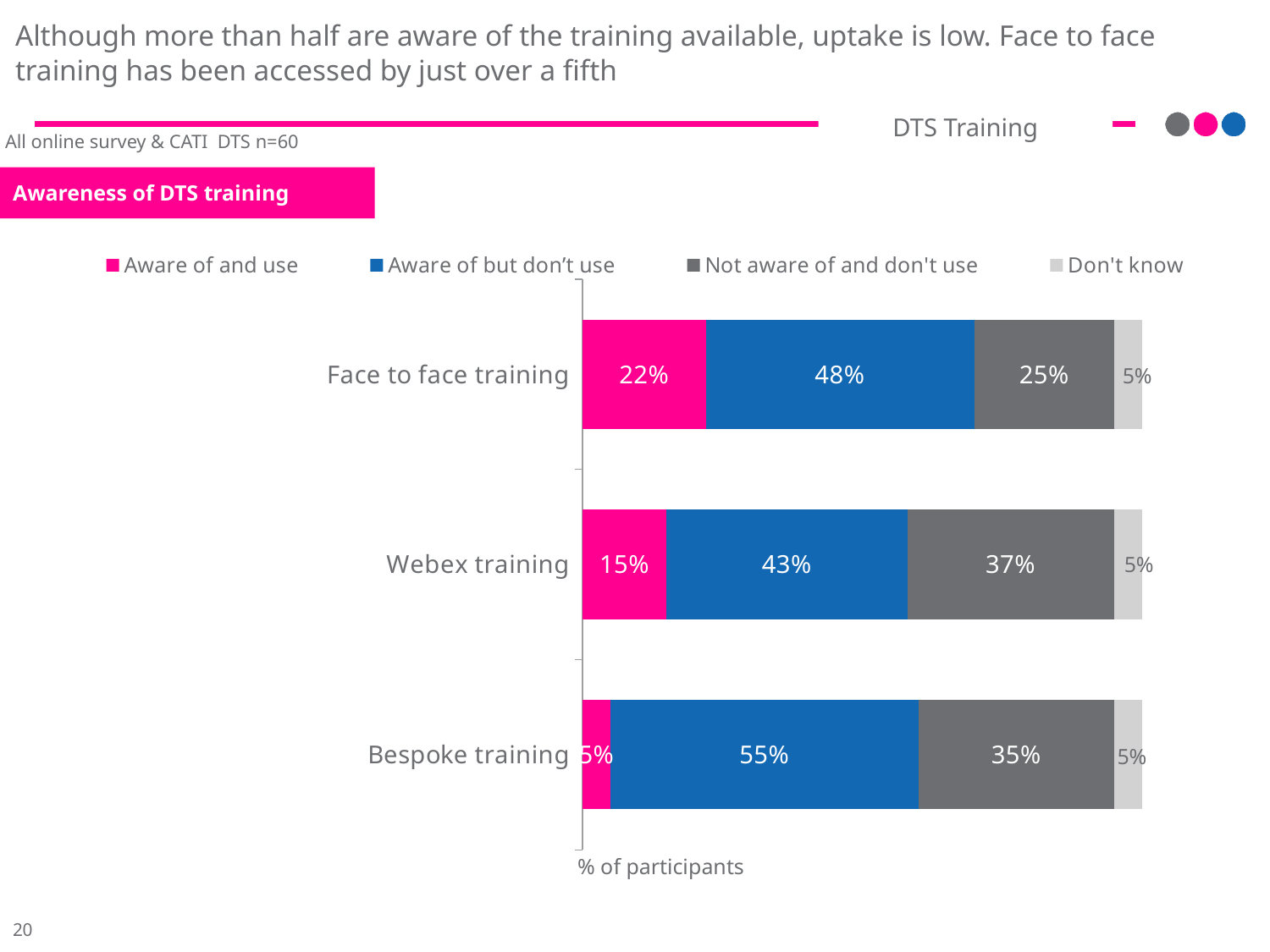
Which training type has the highest 'Aware of and use' percentage? Face to face training What percentage of participants are aware of but don't use Bespoke training? 55% What kind of chart is shown on the slide? Stacked bar chart Which training type has the lowest 'Aware of and use' percentage? Bespoke training What percentage of participants are aware of and use face to face training? 22% How many training types are shown in the chart? 3 Which is larger: the 'Not aware of and don't use' percentage for Webex training or for Face to face training? Webex training What percentage of participants are not aware of and don't use Webex training? 37% What is the difference between the 'Aware of but don't use' percentages for Bespoke training and Webex training? 12% What is the x-axis label of the chart? % of participants What is the 'Don't know' percentage for Webex training? 5% How many series does the legend list? 4